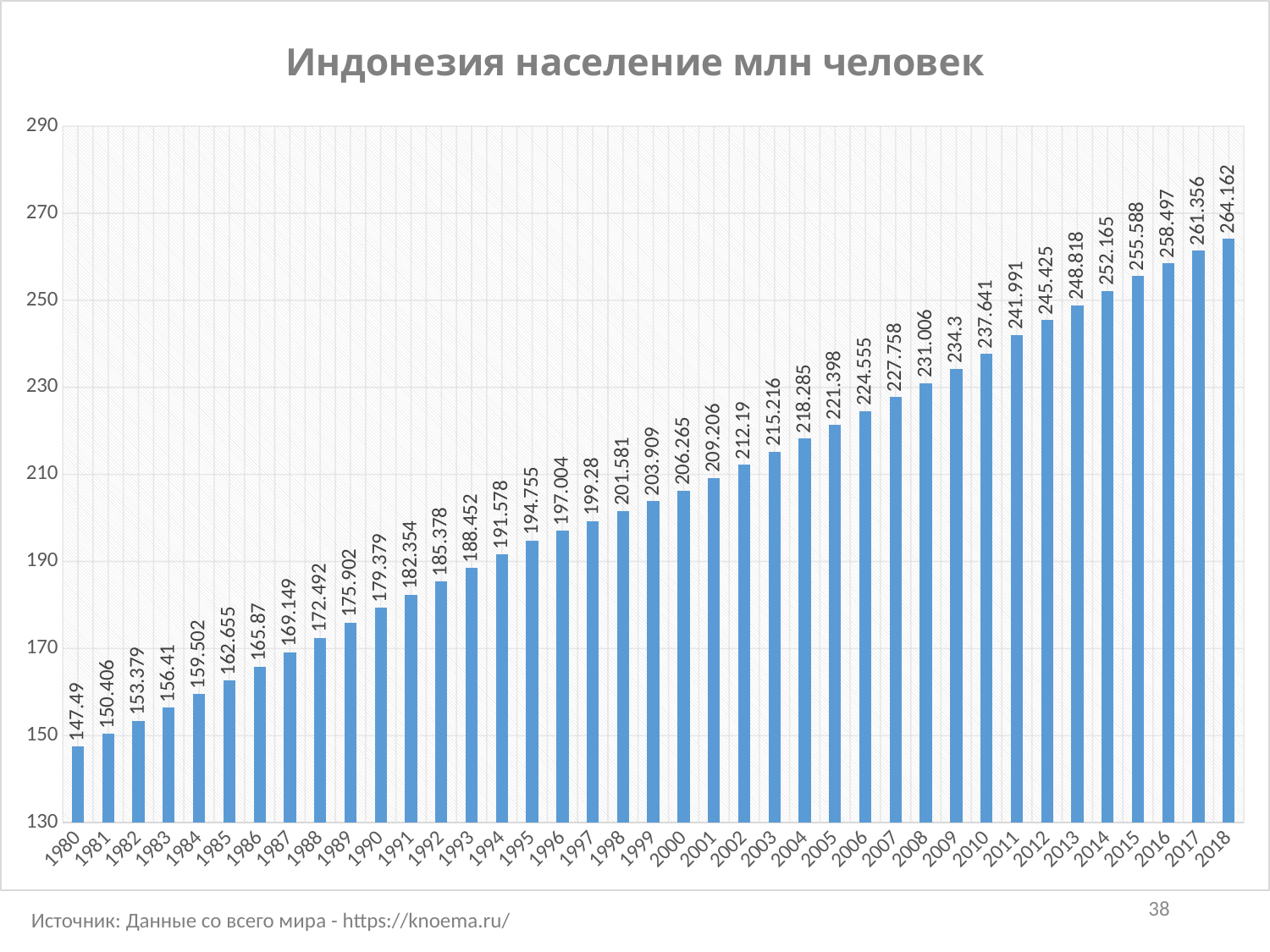
What is the difference between the values for 2018 and 1980? 116.672 Which is larger, the value for 1995 or the value for 2005? 2005 How many years are shown on the x axis? 39 What is the value for 2009? 234.3 What is the title of the chart? Индонезия население млн человек What is the difference between the values for 2010 and 2000? 31.376 What type of chart is shown on the slide? bar chart Which year has the lowest value? 1980 What is the value for 2018? 264.162 What is the value for 1980? 147.49 What is the value for 2000? 206.265 Which year has the highest value? 2018